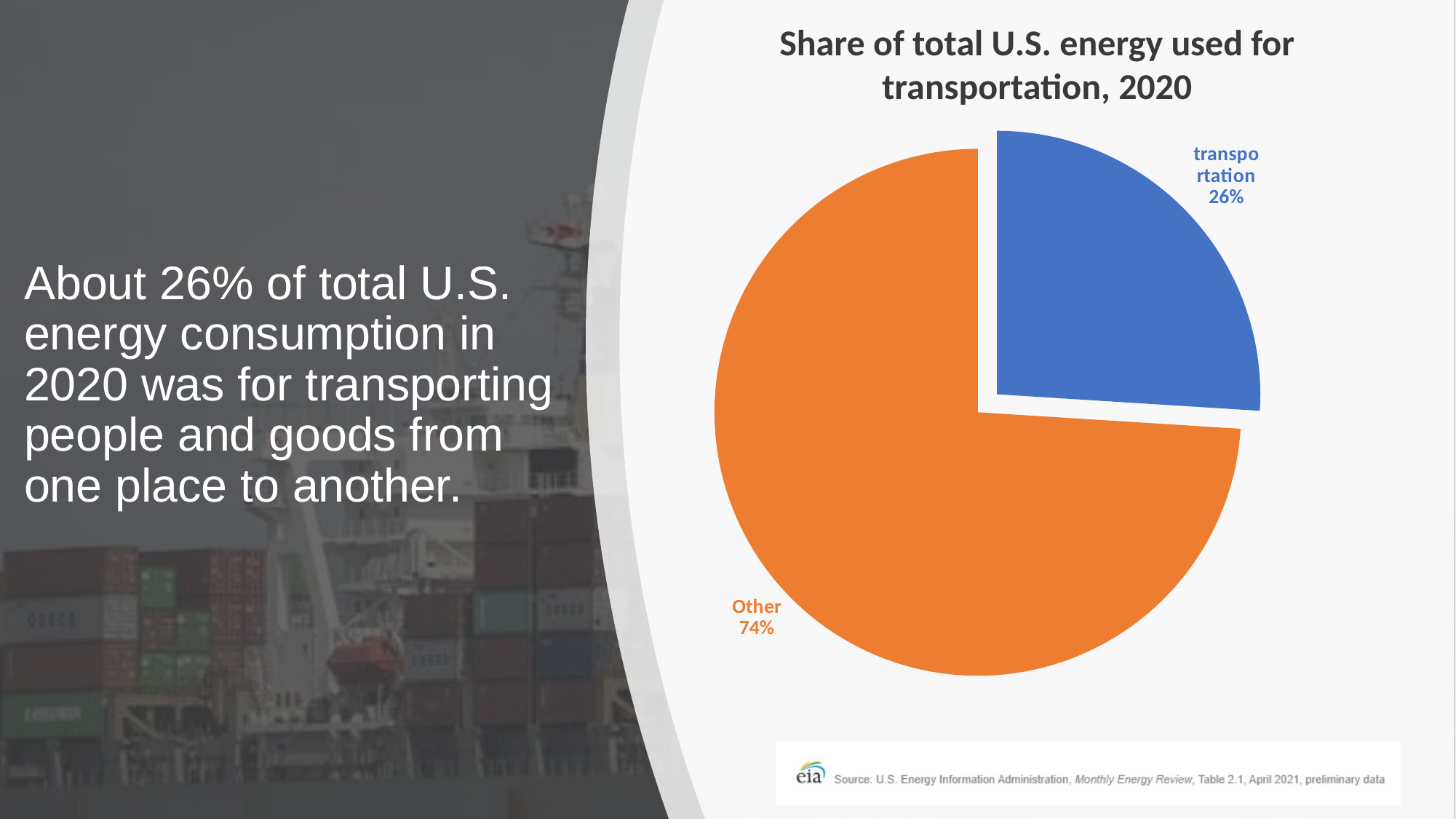
Which is larger, the transportation slice or the Other slice? Other Which slice of the pie is the largest? Other What is the title of the chart? Share of total U.S. energy used for transportation, 2020 Which slice of the pie is the smallest? transportation What colour is the transportation slice? blue What kind of chart is shown on the slide? pie chart What share of total U.S. energy was used for transportation in 2020 according to the chart? 26% How many slices does the pie chart have? 2 What is the difference in percentage points between the Other slice and the transportation slice? 48 What share does the Other slice represent? 74% What is the combined share of the transportation and Other slices? 100%